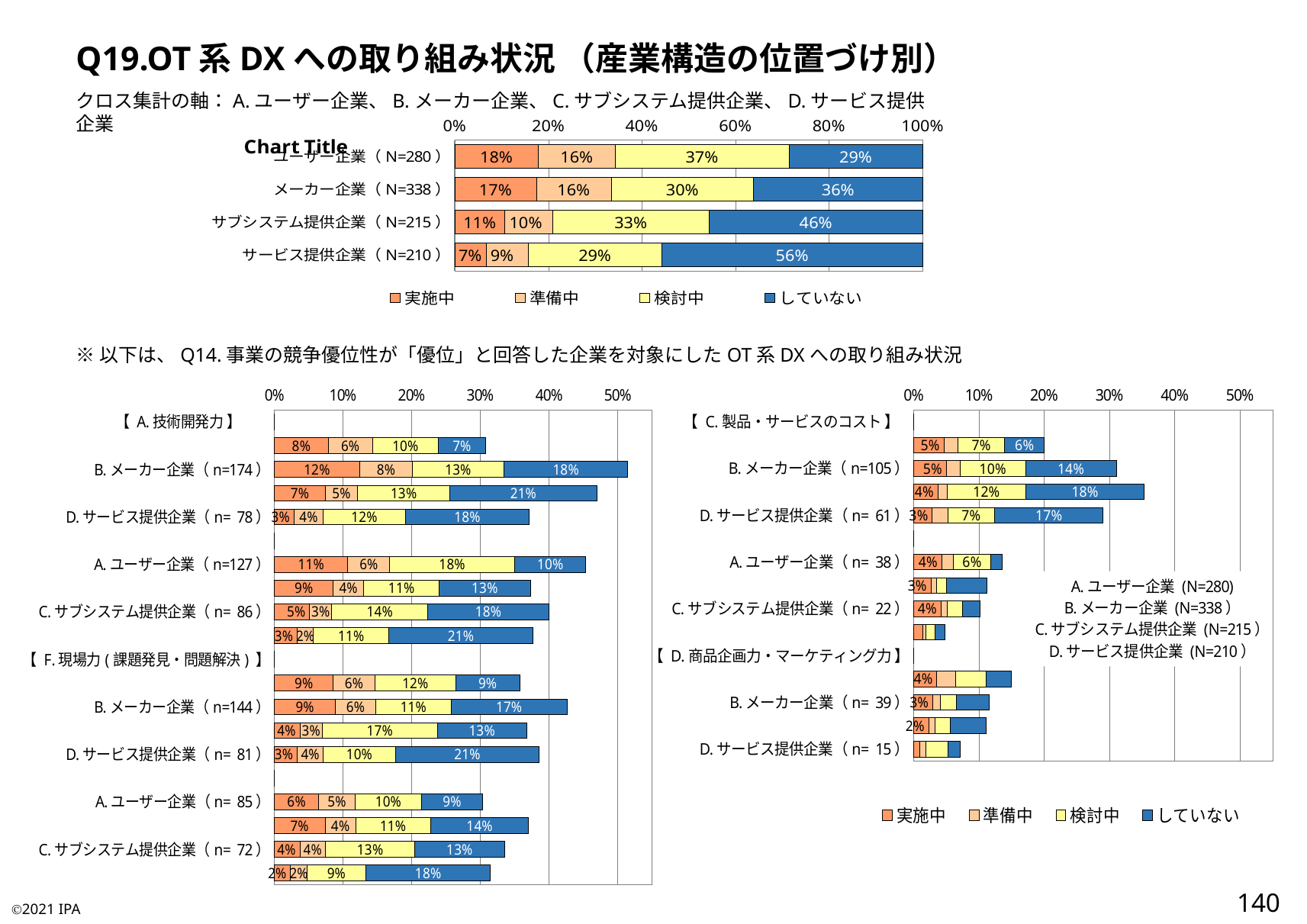
In the top chart, which category has the highest value for していない? サービス提供企業 (N=210) In the top chart, how many categories are plotted? 4 In the bottom-right chart, what is the value of していない for D. サービス提供企業 (n=61)? 17% In the bottom-left chart, what is the value of していない for B. メーカー企業 (n=174)? 18% In the top chart, what is the value of 実施中 for ユーザー企業 (N=280)? 18% What kind of chart is the top chart? Stacked bar chart In the top chart, which is larger: 検討中 for ユーザー企業 (N=280) or 検討中 for メーカー企業 (N=338)? ユーザー企業 (N=280) In the top chart, what is the value of していない for サービス提供企業 (N=210)? 56% In the top chart, what is the value of 検討中 for サブシステム提供企業 (N=215)? 33% In the top chart, which category has the lowest value for 実施中? サービス提供企業 (N=210) In the top chart, how many series does the legend list? 4 In the top chart, what is the difference between the していない values for メーカー企業 (N=338) and ユーザー企業 (N=280)? 7%